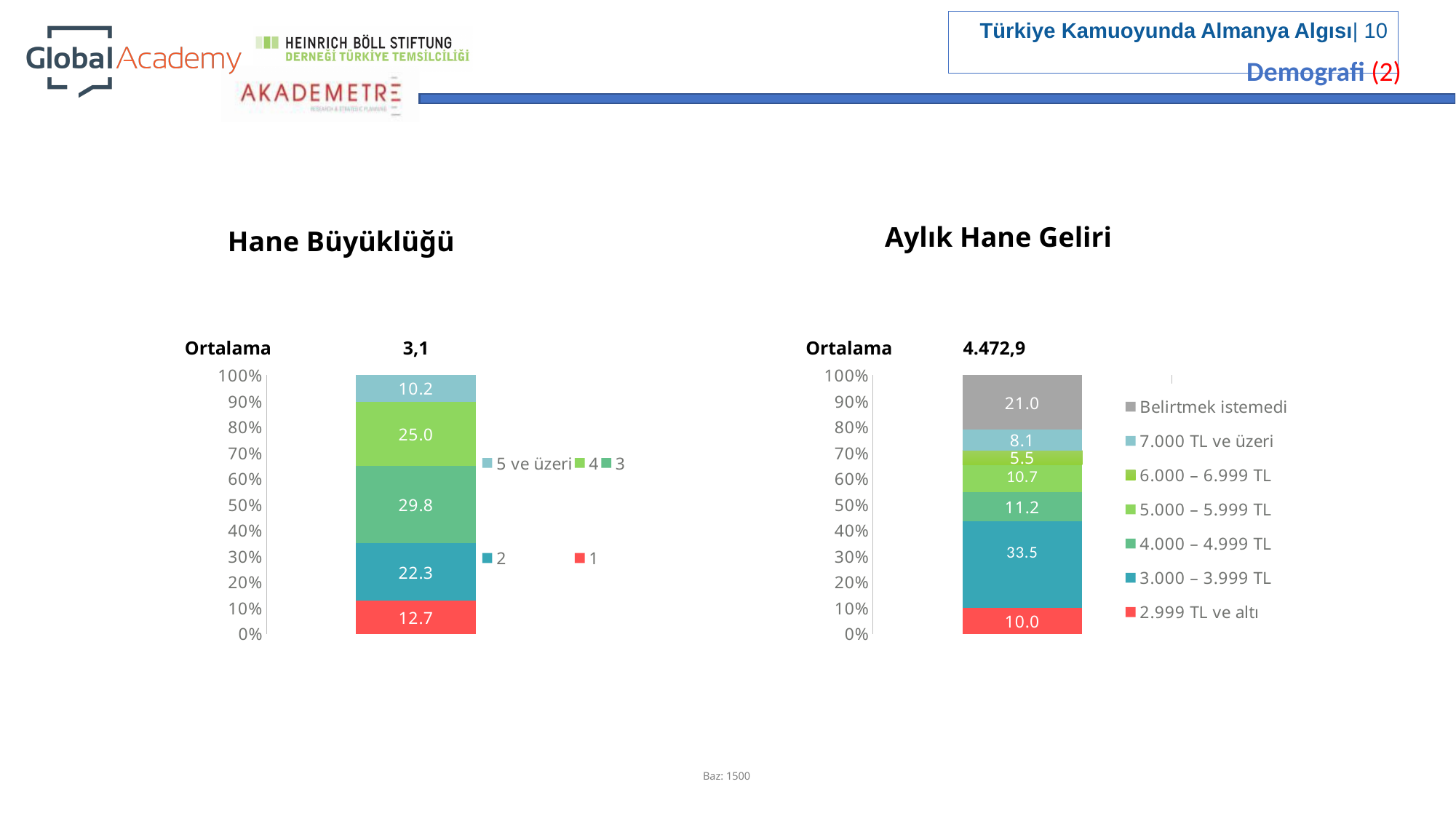
What type of chart is the "Aylık Hane Geliri" chart? Stacked bar chart In the "Aylık Hane Geliri" chart, what is the value for "3.000 – 3.999 TL"? 33.5 In the "Aylık Hane Geliri" chart, what is the value for "Belirtmek istemedi"? 21.0 In the "Aylık Hane Geliri" chart, which is larger: "7.000 TL ve üzeri" or "4.000 – 4.999 TL"? 4.000 – 4.999 TL In the "Aylık Hane Geliri" chart, which segment has the smallest value? 6.000 – 6.999 TL In the "Hane Büyüklüğü" chart, how many series does the legend list? 5 In the "Hane Büyüklüğü" chart, what is the value for "5 ve üzeri"? 10.2 In the "Hane Büyüklüğü" chart, what is the value for the "3" segment? 29.8 In the "Aylık Hane Geliri" chart, what is the difference between "3.000 – 3.999 TL" and "2.999 TL ve altı"? 23.5 In the "Hane Büyüklüğü" chart, which segment has the largest value? 3 In the "Aylık Hane Geliri" chart, how many series does the legend list? 7 In the "Hane Büyüklüğü" chart, what is the difference between the values for "2" and "1"? 9.6